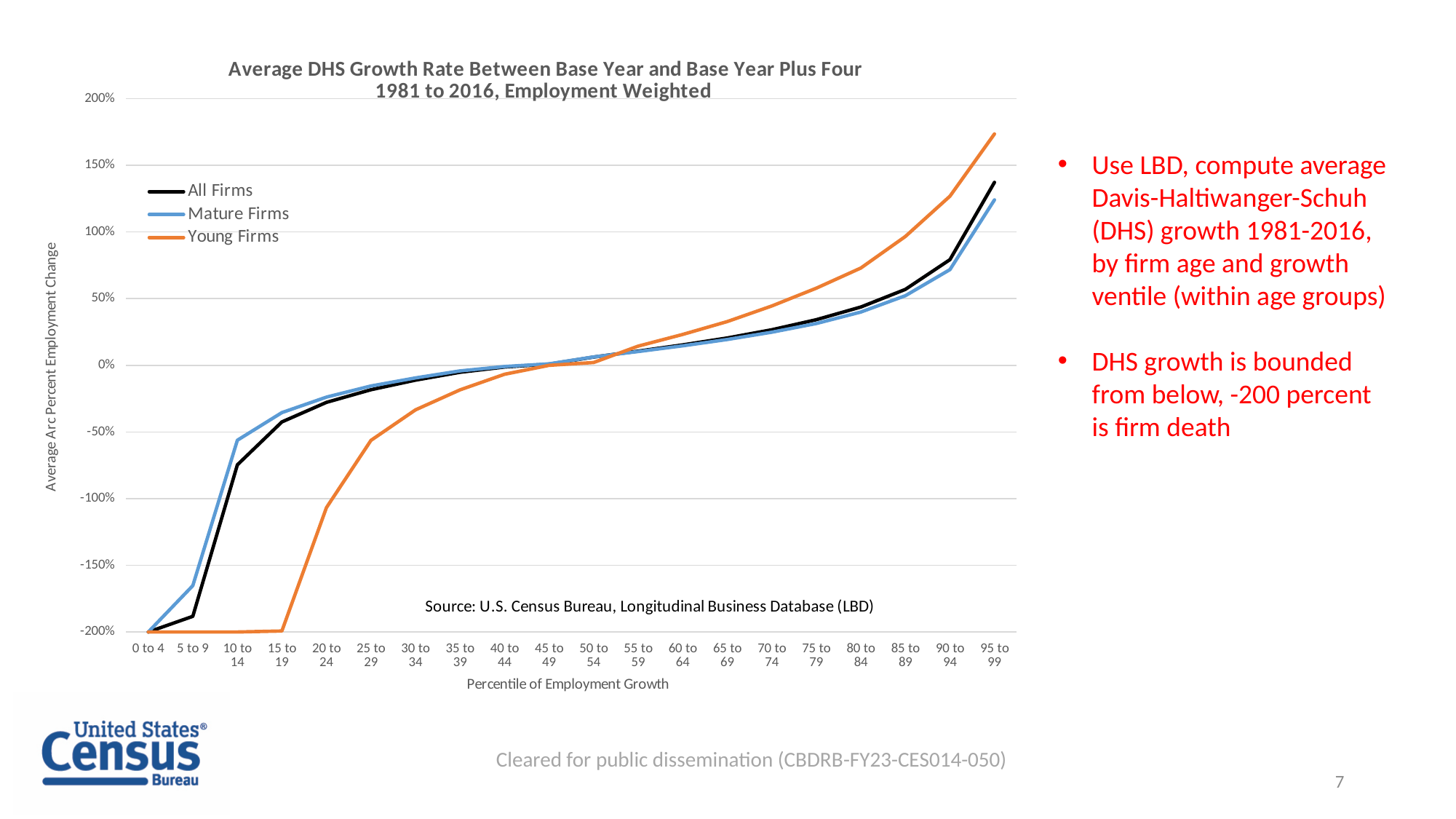
Which series has the lowest value at the 10 to 14 percentile? Young Firms What is the label of the chart's y axis? Average Arc Percent Employment Change Do the values for All Firms rise or fall as the percentile of employment growth increases? Rise Is the value for Young Firms at the 95 to 99 percentile greater or less than 150%? greater How many series does the chart's legend list? 3 What kind of chart is shown on the slide? Line chart Is the value for Mature Firms at the 10 to 14 percentile greater or less than -50%? less At the 10 to 14 percentile, which is larger: the value for Mature Firms or the value for All Firms? Mature Firms How many percentile categories are shown along the x axis? 20 What is the value for All Firms at the 0 to 4 percentile? -200% Which series has the highest value at the 95 to 99 percentile? Young Firms